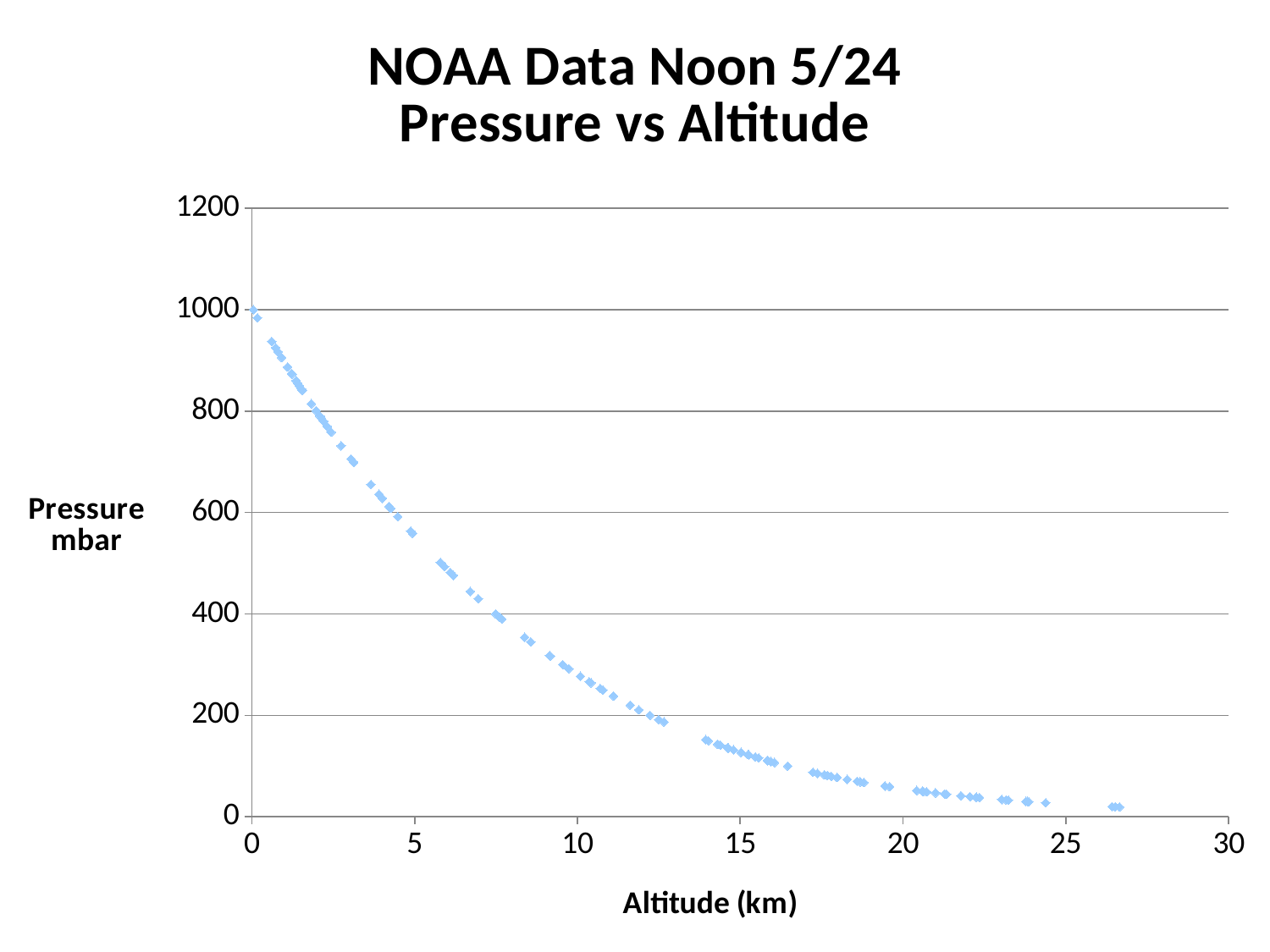
What is the label of the x axis? Altitude (km) At which end of the altitude range is pressure highest, 0 km or 26 km? 0 km Is the pressure at an altitude of 15 km greater or less than 200 mbar? less What kind of chart is shown on the slide? scatter chart Is the pressure at an altitude of 10 km greater or less than 400 mbar? less What is the title of the chart? NOAA Data Noon 5/24 Pressure vs Altitude Which has the higher pressure: the point at 5 km altitude or the point at 10 km altitude? 5 km Is the pressure at an altitude of 2 km greater or less than 600 mbar? greater Does pressure rise or fall as altitude increases along the x axis? fall